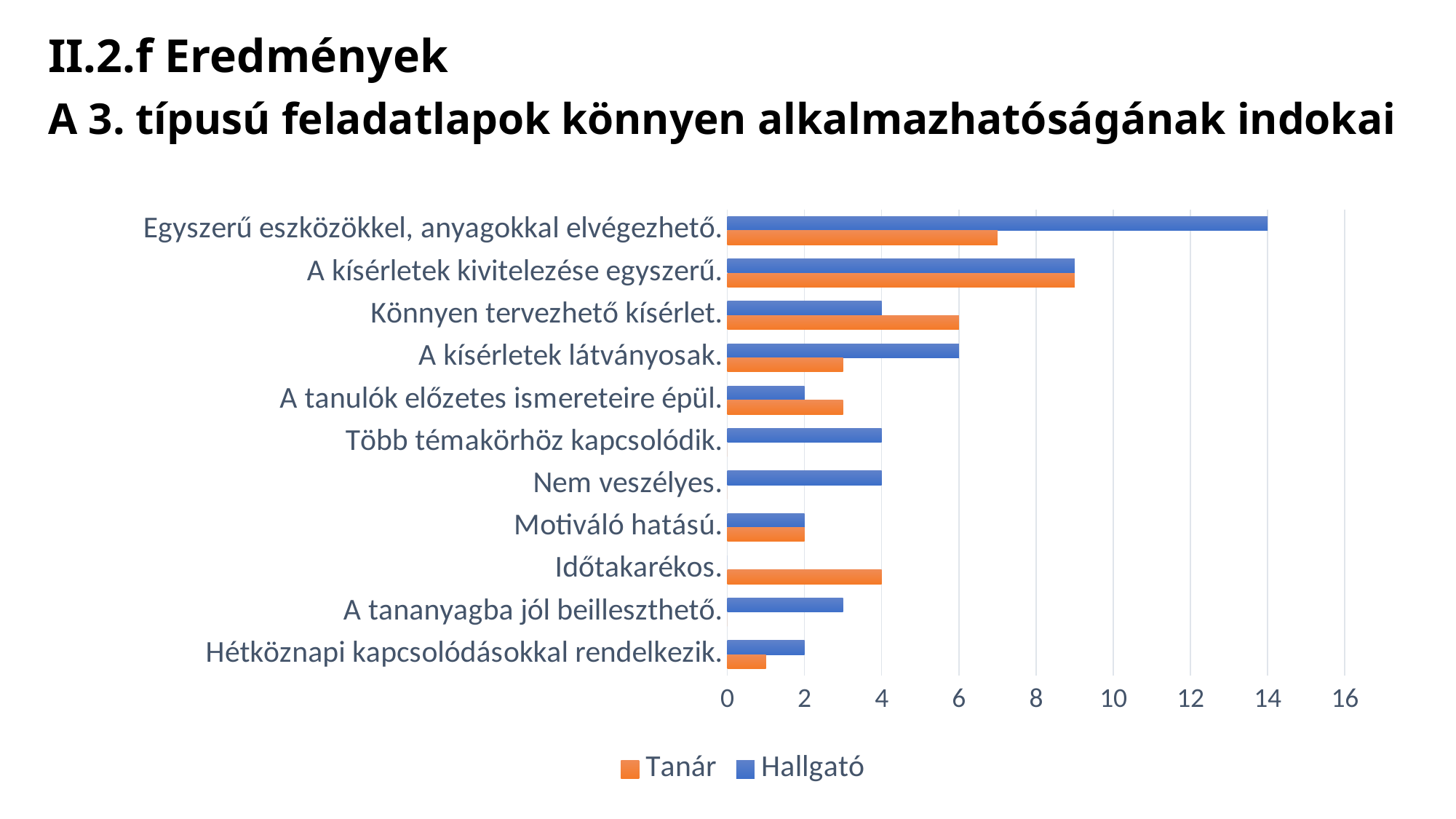
What is the Tanár value for 'Időtakarékos.'? 4 Which category has the highest Hallgató value? Egyszerű eszközökkel, anyagokkal elvégezhető. Is the Tanár value for 'Egyszerű eszközökkel, anyagokkal elvégezhető.' greater or less than 6? greater Which colour represents the Tanár series in the legend? orange What is the Tanár value for 'Könnyen tervezhető kísérlet.'? 6 For 'Könnyen tervezhető kísérlet.', which series has the larger value, Tanár or Hallgató? Tanár What is the difference between the Tanár and Hallgató values for 'Könnyen tervezhető kísérlet.'? 2 What is the Hallgató value for 'Nem veszélyes.'? 4 How many categories are shown on the chart? 11 What type of chart is shown on the slide? bar chart How many series does the legend list? 2 What is the Hallgató value for 'Egyszerű eszközökkel, anyagokkal elvégezhető.'? 14